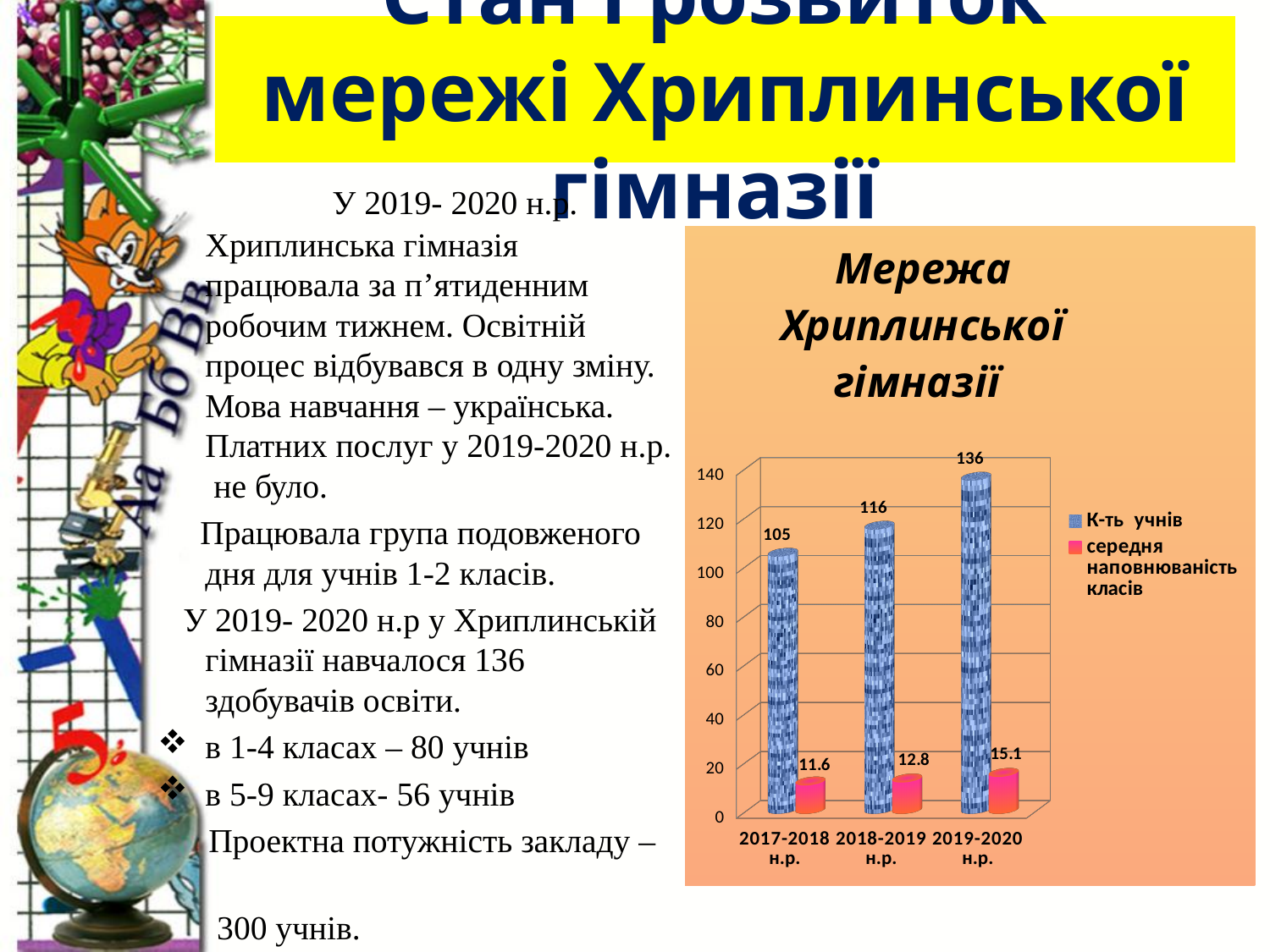
What is the value of "К-ть учнів" for 2017-2018 н.р.? 105 How many series does the chart legend list? 2 How many school years are shown on the x axis of the chart? 3 What is the difference in "К-ть учнів" between 2019-2020 н.р. and 2018-2019 н.р.? 20 Which school year has the lowest value for "середня наповнюваність класів"? 2017-2018 н.р. What is the value of "середня наповнюваність класів" for 2017-2018 н.р.? 11.6 What is the value of "К-ть учнів" for 2019-2020 н.р.? 136 Which is larger: "К-ть учнів" for 2018-2019 н.р. or for 2017-2018 н.р.? 2018-2019 н.р. Does "К-ть учнів" rise or fall from 2017-2018 н.р. to 2019-2020 н.р.? Rises What is the value of "середня наповнюваність класів" for 2018-2019 н.р.? 12.8 What kind of chart is shown on the slide? Bar chart Which school year has the highest value for "К-ть учнів"? 2019-2020 н.р.